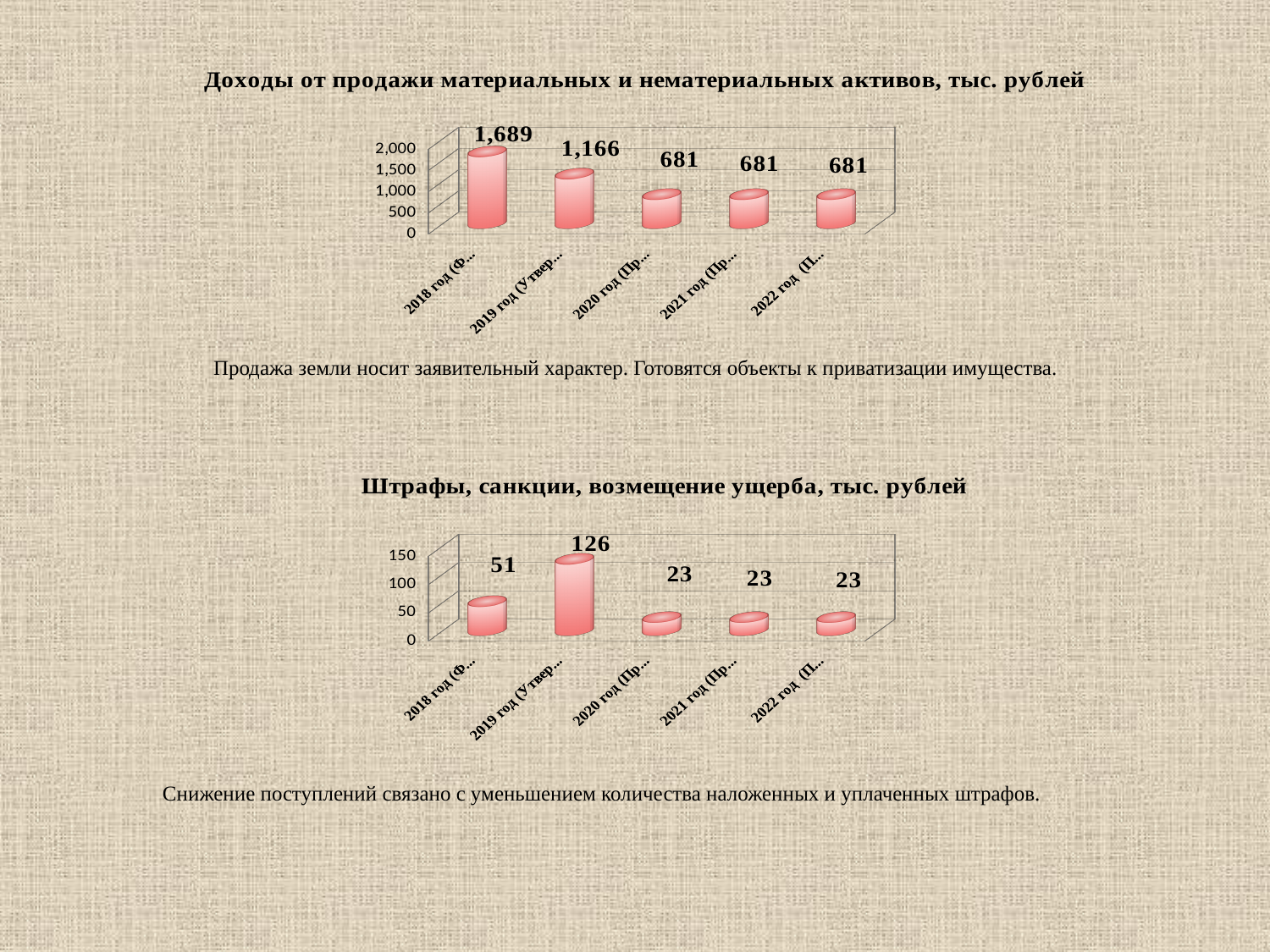
In the top chart (Доходы от продажи материальных и нематериальных активов), how many bars are plotted? 5 In the bottom chart (Штрафы, санкции, возмещение ущерба), which is larger, the value for 2018 год or 2019 год? 2019 год In the bottom chart (Штрафы, санкции, возмещение ущерба), what is the value for 2021 год? 23 In the top chart (Доходы от продажи материальных и нематериальных активов), do the values rise or fall from 2018 to 2020? fall In the top chart (Доходы от продажи материальных и нематериальных активов), which year has the highest value? 2018 год In the top chart (Доходы от продажи материальных и нематериальных активов), what is the value for 2018 год? 1,689 In the bottom chart (Штрафы, санкции, возмещение ущерба), what is the value for 2019 год? 126 What type of chart is the bottom chart (Штрафы, санкции, возмещение ущерба)? bar chart In the bottom chart (Штрафы, санкции, возмещение ущерба), which year has the highest value? 2019 год In the bottom chart (Штрафы, санкции, возмещение ущерба), what is the difference between the values for 2019 год and 2018 год? 75 In the top chart (Доходы от продажи материальных и нематериальных активов), what is the difference between the values for 2018 год and 2019 год? 523 In the top chart (Доходы от продажи материальных и нематериальных активов), what is the value for 2019 год? 1,166